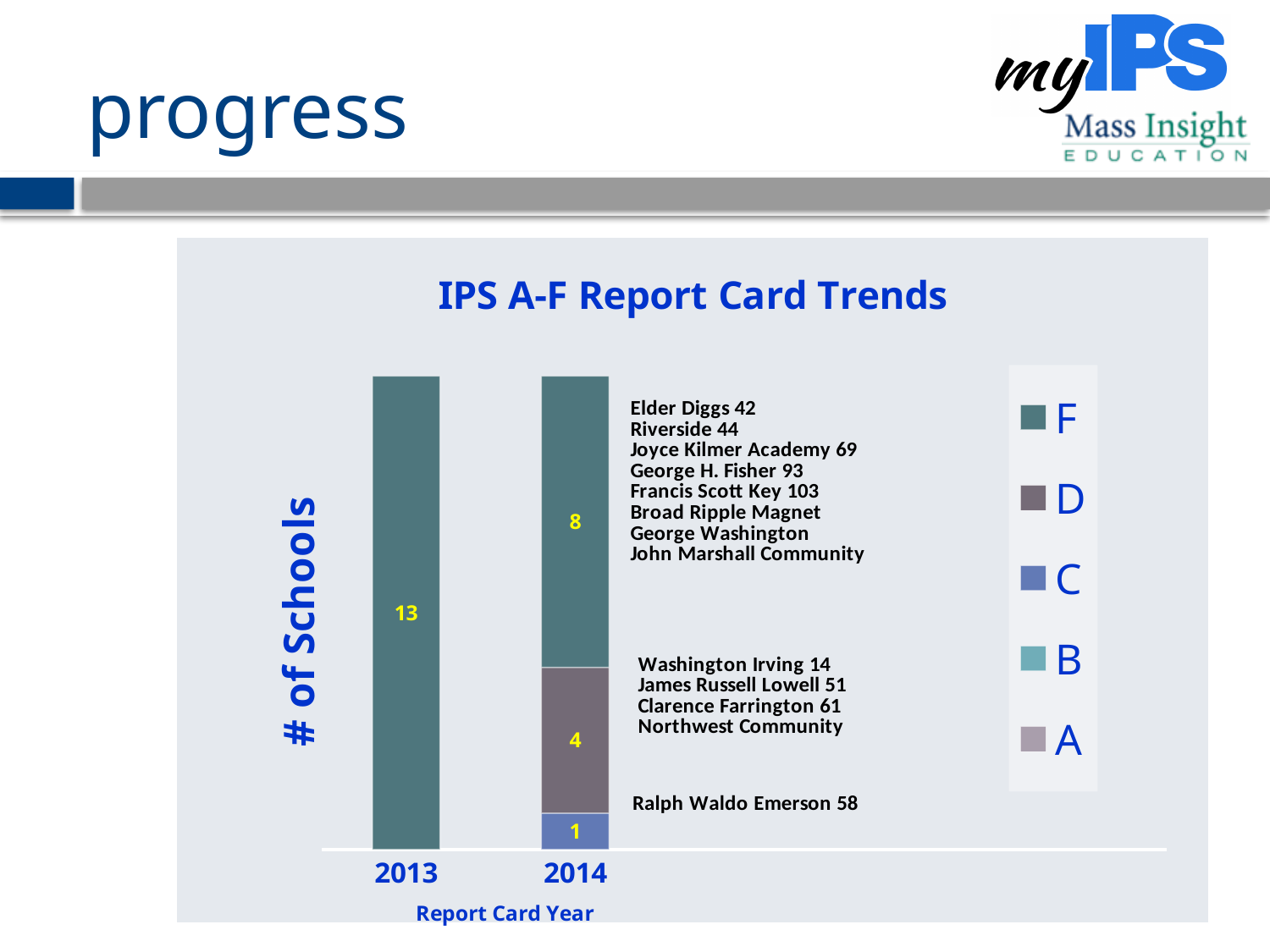
What is the total number of schools in the 2014 bar? 13 How many schools received a D in 2014? 4 How many report card years are shown on the x axis? 2 What is the difference between the number of F schools in 2013 and in 2014? 5 How many schools received an F in 2014? 8 How many series does the legend list? 5 What is the label of the y axis? # of Schools What kind of chart is shown on the slide? stacked bar chart Which grade has more schools in 2014, D or C? D How many schools received a C in 2014? 1 What is the title of the chart? IPS A-F Report Card Trends How many schools received an F in 2013? 13